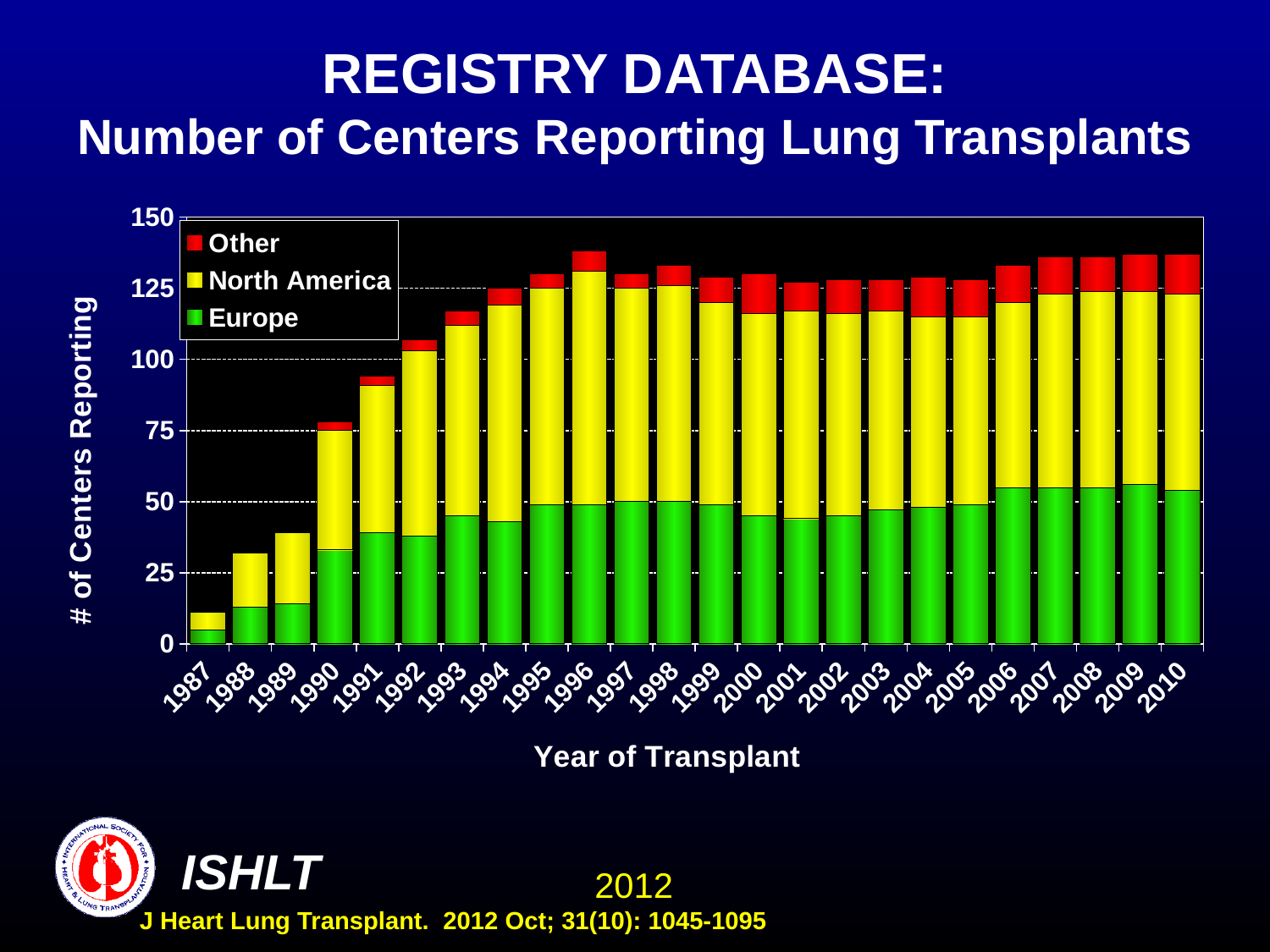
Which series is shown in green? Europe How many series does the legend list? 3 Which year has the larger total number of centers reporting, 1990 or 1995? 1995 Is the total number of centers reporting in 2010 greater or less than 125? greater Does the total number of centers reporting generally rise or fall from 1987 to 2010? rise Is the total number of centers reporting in 1987 greater or less than 25? less What kind of chart is shown on the slide? stacked bar chart Which year has the lowest total number of centers reporting? 1987 Is the total number of centers reporting in 1992 greater or less than 100? greater What is the label of the x axis? Year of Transplant How many years are shown along the x axis? 24